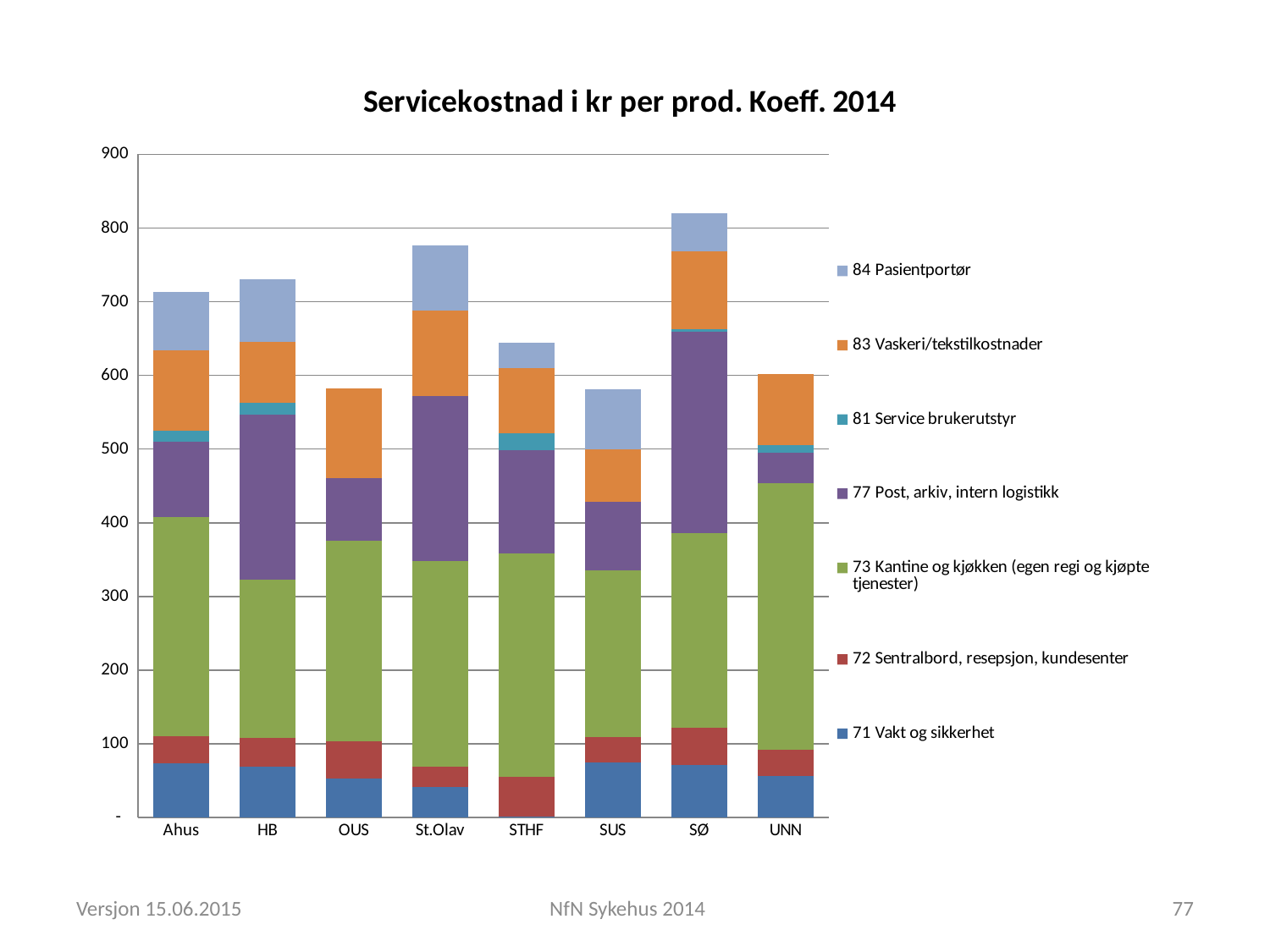
What is the title of the chart? Servicekostnad i kr per prod. Koeff. 2014 What kind of chart is shown on the slide? Stacked bar chart Which has the larger total bar, St.Olav or HB? St.Olav Which legend entry is shown in green? 73 Kantine og kjøkken (egen regi og kjøpte tjenester) Which hospital has the highest total stacked bar? SØ How many series does the legend list? 7 Is the total value for STHF greater or less than 700? less Is the total value for SØ greater or less than 800? greater Is the total value for UNN greater or less than 700? less How many hospitals (categories) are shown on the x axis? 8 Which has the larger total bar, SUS or SØ? SØ